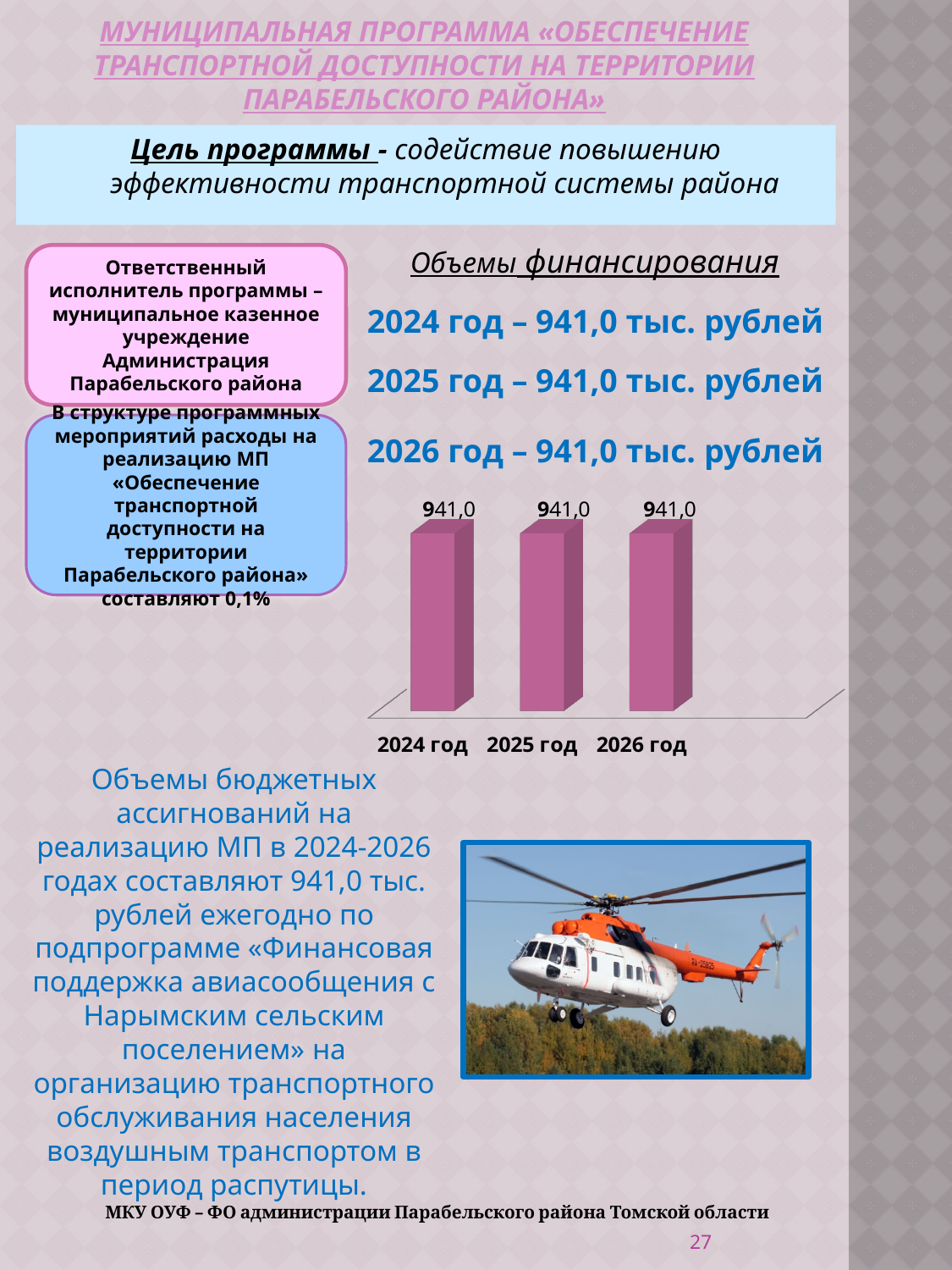
What are the category labels along the x axis of the chart? 2024 год, 2025 год, 2026 год What is the difference between the values for 2025 год and 2024 год in the bar chart? 0 What kind of chart is shown on the slide? Bar chart How many bars (categories) are shown in the chart? 3 Do the values in the chart rise, fall, or stay the same from 2024 год to 2026 год? Stay the same What colour are the bars in the chart? Pink (magenta) Is the value for 2025 год larger than, smaller than, or equal to the value for 2026 год? Equal What is the value shown for 2026 год in the bar chart? 941,0 What is the value shown for 2025 год in the bar chart? 941,0 What is the difference between the values for 2024 год and 2026 год in the bar chart? 0 What is the value shown for 2024 год in the bar chart? 941,0